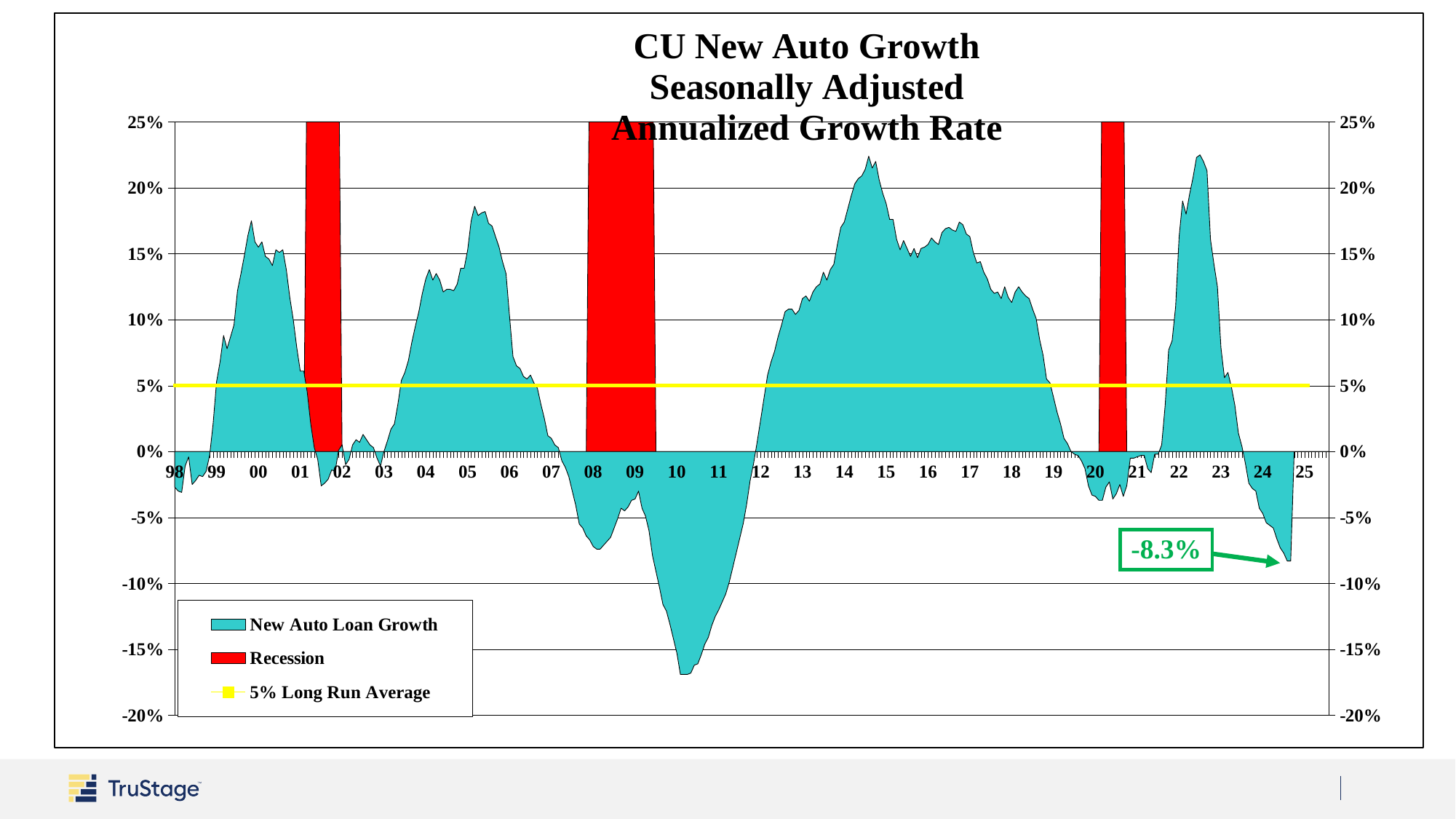
What is the value of the long run average line shown on the chart? 5% Does new auto loan growth rise or fall between 2023 and 2025? fall How many recession periods are shaded on the chart? 3 What kind of chart is shown on the slide? area chart Is the value of new auto loan growth at the 2005 peak greater or less than 15%? greater What colour is used for the recession periods in the chart? red Is the lowest value of new auto loan growth around 2010 greater or less than -15%? less Does new auto loan growth rise or fall between 2021 and 2022? rise What is the most recent value of new auto loan growth labeled on the chart? -8.3% Is the peak value of new auto loan growth around 2014-2015 greater or less than 20%? greater How many entries does the chart's legend list? 3